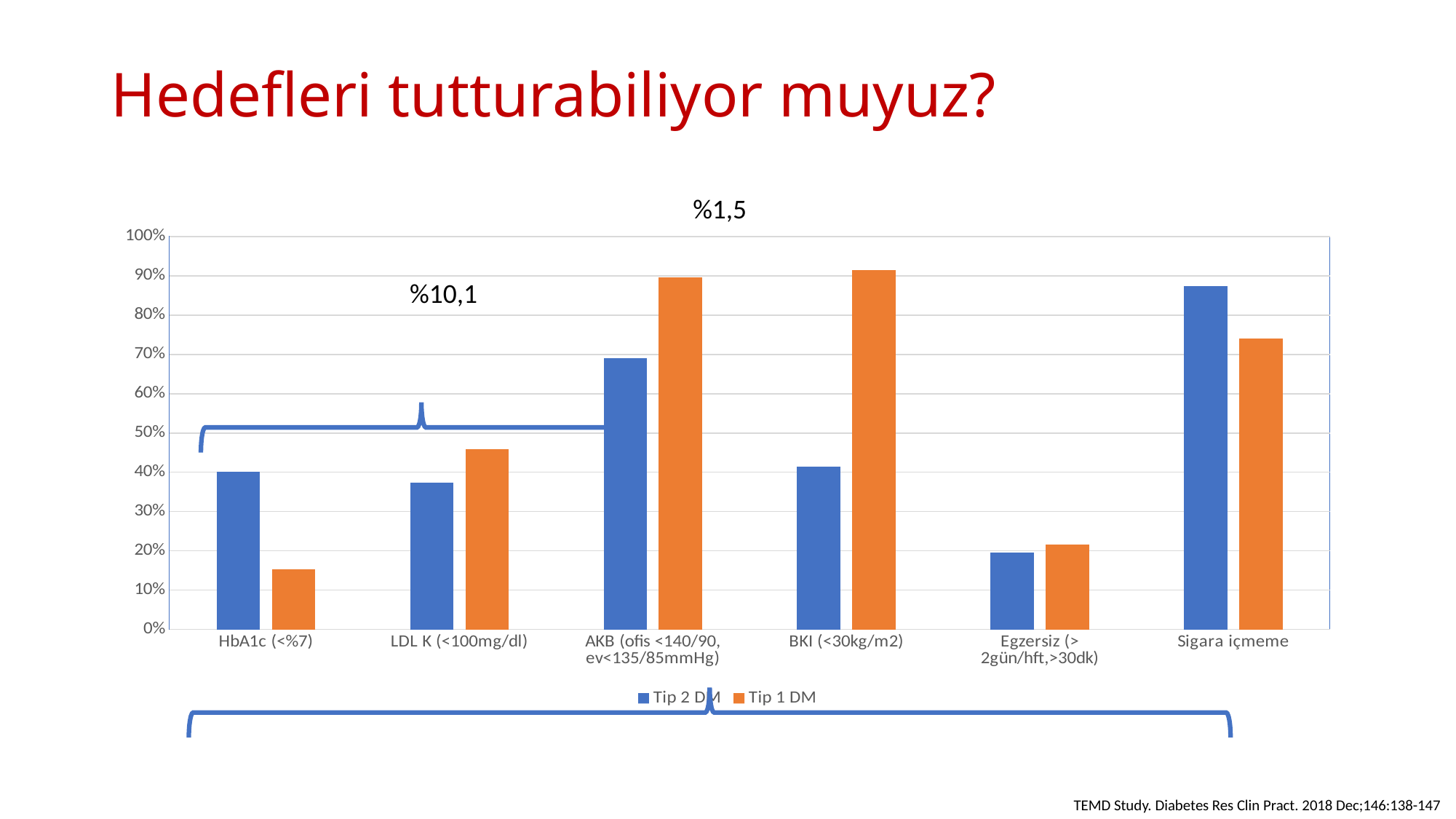
How many series does the legend list? 2 For AKB (ofis <140/90, ev<135/85mmHg), which series has the larger value, Tip 2 DM or Tip 1 DM? Tip 1 DM What kind of chart is shown on the slide? bar chart Is the Tip 1 DM value for HbA1c (<%7) greater or less than 20%? less Which colour represents Tip 1 DM in the legend? orange Is the Tip 2 DM value for BKI (<30kg/m2) greater or less than 50%? less Is the Tip 1 DM value for AKB (ofis <140/90, ev<135/85mmHg) greater or less than 80%? greater Which category has the highest value for Tip 2 DM? Sigara içmeme Which category has the lowest value for Tip 1 DM? HbA1c (<%7) Which category has the lowest value for Tip 2 DM? Egzersiz (> 2gün/hft,>30dk) How many categories are shown on the x axis? 6 For HbA1c (<%7), which series has the larger value, Tip 2 DM or Tip 1 DM? Tip 2 DM